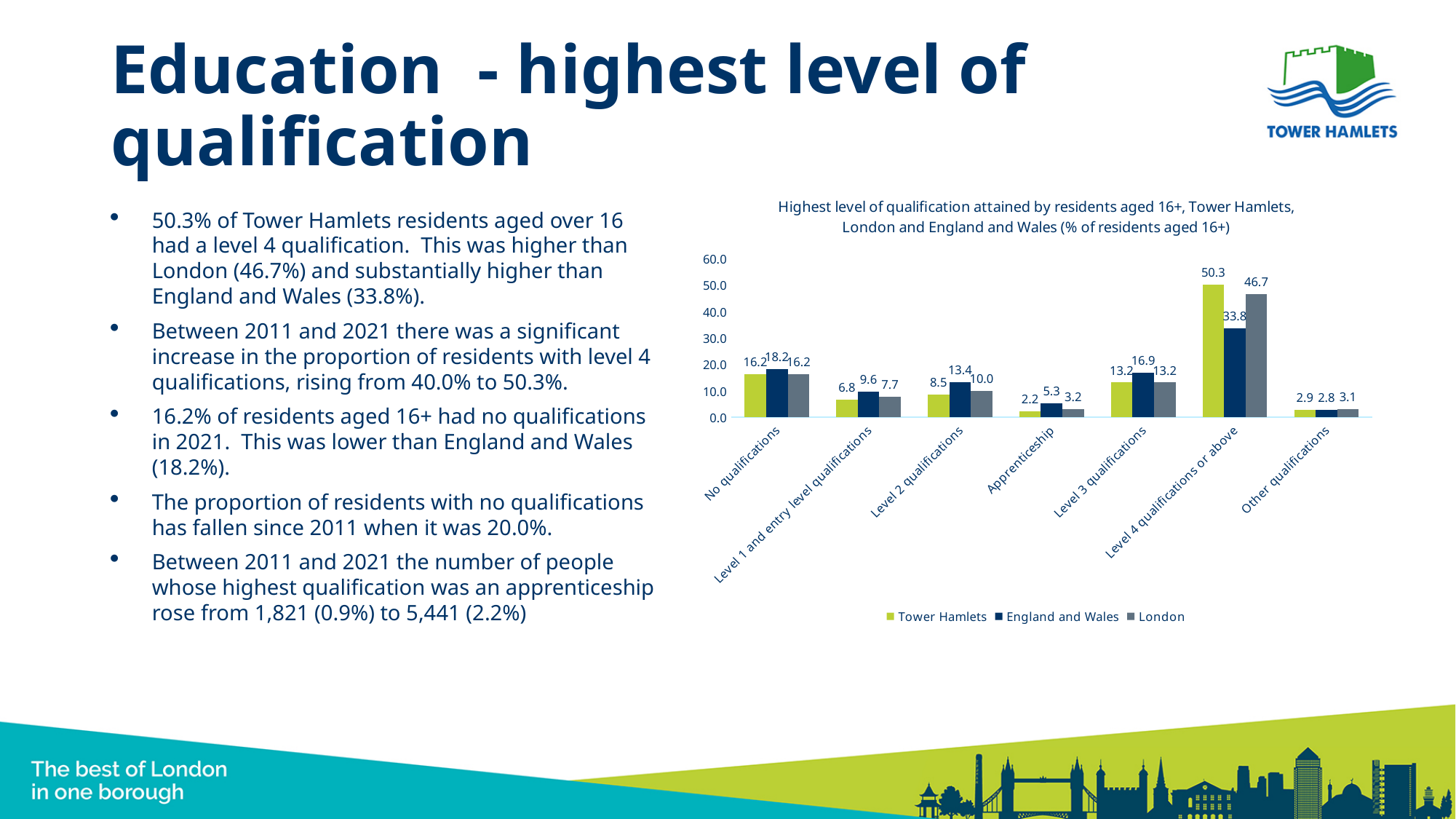
What is the value for Tower Hamlets in the Level 4 qualifications or above category? 50.3 What is the value for England and Wales in the Apprenticeship category? 5.3 Which is larger in the Level 3 qualifications category, the value for England and Wales or the value for Tower Hamlets? England and Wales Which category has the highest value for Tower Hamlets? Level 4 qualifications or above What is the difference between the Tower Hamlets and London values for Level 4 qualifications or above? 3.6 What is the value for London in the Level 2 qualifications category? 10.0 What kind of chart is shown on the slide? Bar chart Is the value for England and Wales in the Level 4 qualifications or above category greater or less than 40.0? less How many qualification categories are shown on the x axis? 7 Which category has the lowest value for England and Wales? Other qualifications Which series is shown in green in the legend? Tower Hamlets How many series does the legend list? 3